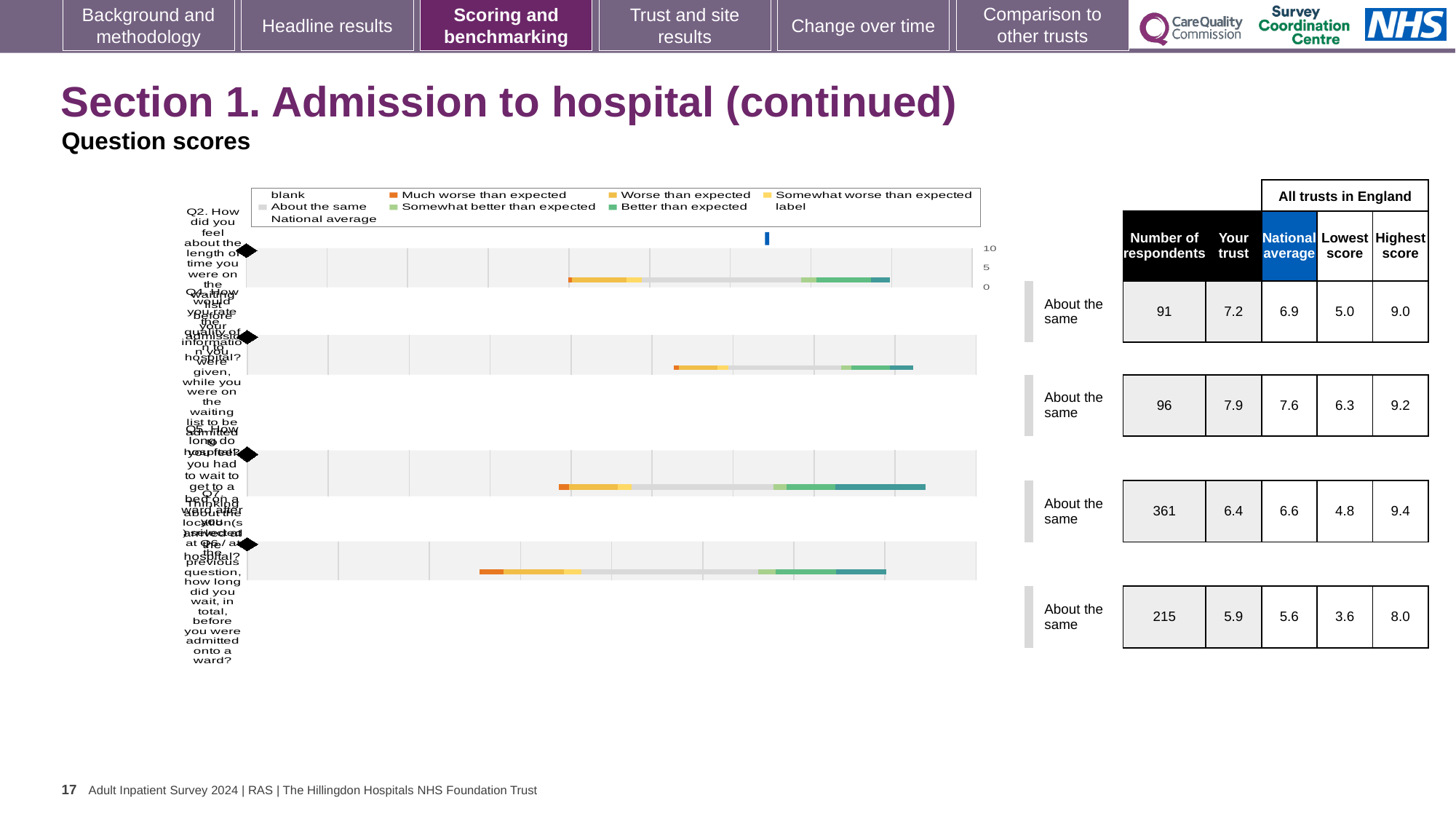
In the table beside the chart, what is the national average for the third question? 6.6 In the table beside the chart, what is the lowest score for the fourth (bottom) question? 3.6 How many question bars are plotted in the chart? 4 What is the highest tick value shown on the chart's numeric axis? 10 For the first question in the table, what is the difference between the highest score and the lowest score? 4.0 In the chart legend, which category is shown in dark orange? Much worse than expected In the table beside the chart, what is the 'Your trust' score for the second question? 7.9 Which question in the table has the highest number of respondents? the third question (361) For the third question in the table, which is larger: the 'Your trust' score or the national average? National average What benchmark category is shown for every question in the chart? About the same In the table beside the chart, what is the number of respondents for the first (top) question? 91 What kind of chart is shown on the slide? bar chart